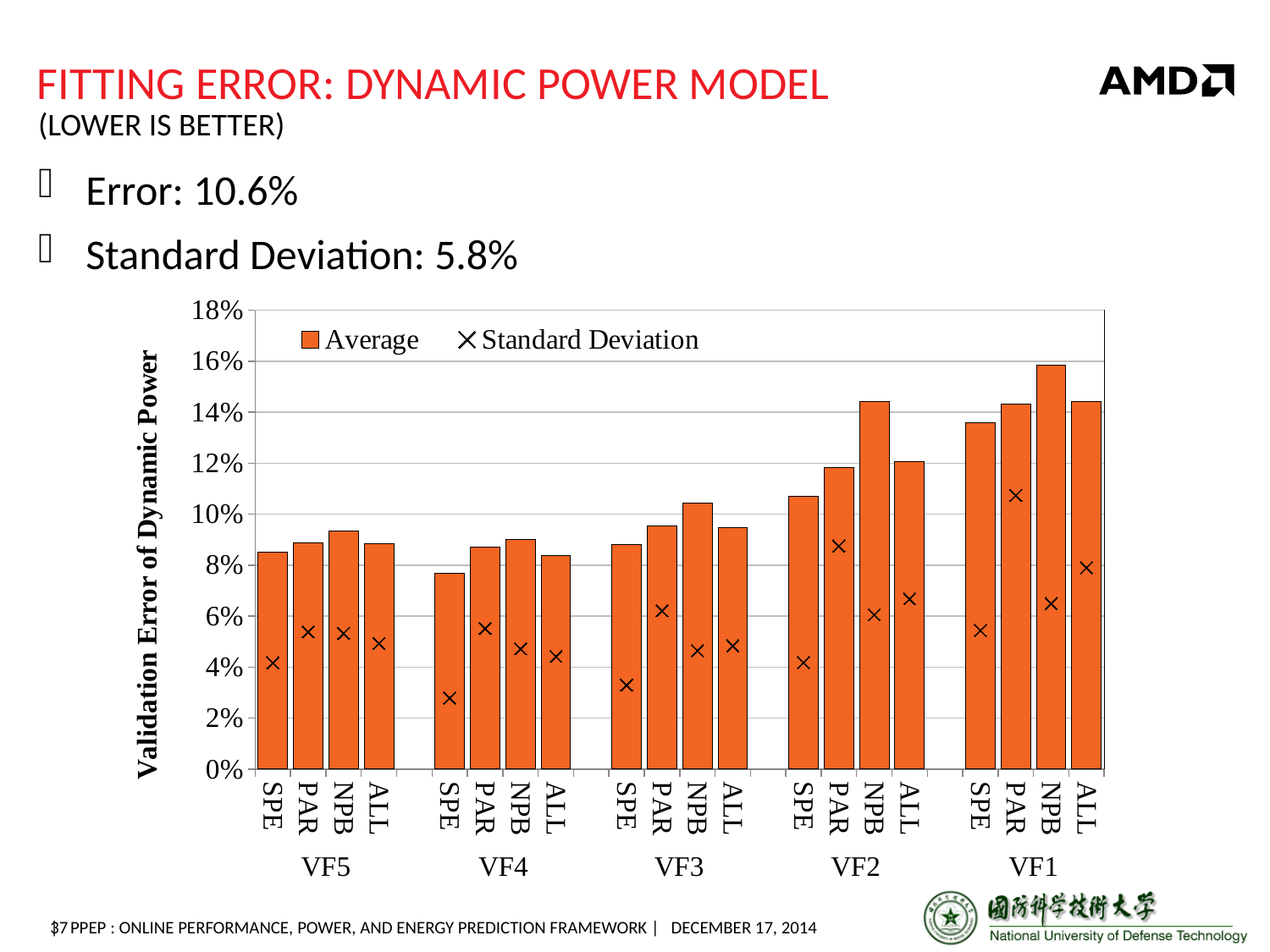
What are the two series named in the chart legend? Average and Standard Deviation How many VF groups are shown along the x axis? 5 How many bars are plotted in the chart? 20 How many series does the chart legend list? 2 Is the Average value for NPB in VF1 greater or less than 14%? greater Is the Average value for SPE in VF4 greater or less than 8%? less What is the title of the vertical axis of the chart? Validation Error of Dynamic Power Which bar has the lowest Average validation error? SPE in VF4 What kind of chart is shown on the slide? bar chart Which bar has the highest Average validation error? NPB in VF1 Which has the larger Average validation error, NPB in VF1 or NPB in VF5? NPB in VF1 Is the Standard Deviation marker for SPE in VF4 greater or less than 4%? less